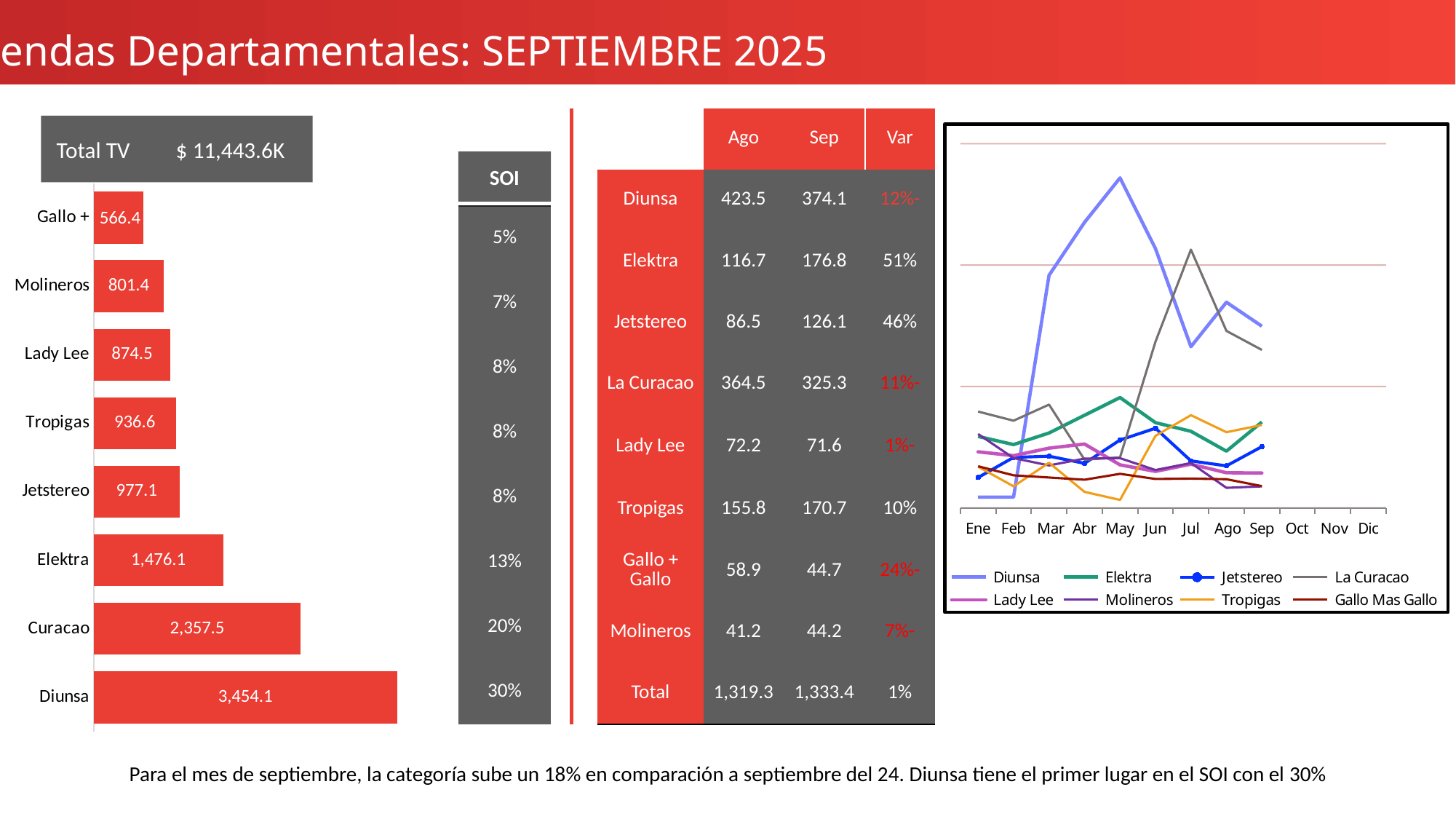
In the bar chart on the left, which category has the lowest value? Gallo + In the bar chart on the left, what is the value for Diunsa? 3,454.1 What kind of chart is the chart on the left of the slide? Bar chart In the line chart on the right, in which month does the Diunsa line reach its peak? May In the bar chart on the left, which is larger, the value for Jetstereo or the value for Lady Lee? Jetstereo How many series does the legend of the line chart on the right list? 8 How many categories are shown in the bar chart on the left? 8 In the bar chart on the left, what is the value for Elektra? 1,476.1 In the bar chart on the left, what is the difference between the values for Curacao and Elektra? 881.4 In the bar chart on the left, what is the value for Tropigas? 936.6 What kind of chart is the chart on the right of the slide? Line chart In the bar chart on the left, which category has the highest value? Diunsa